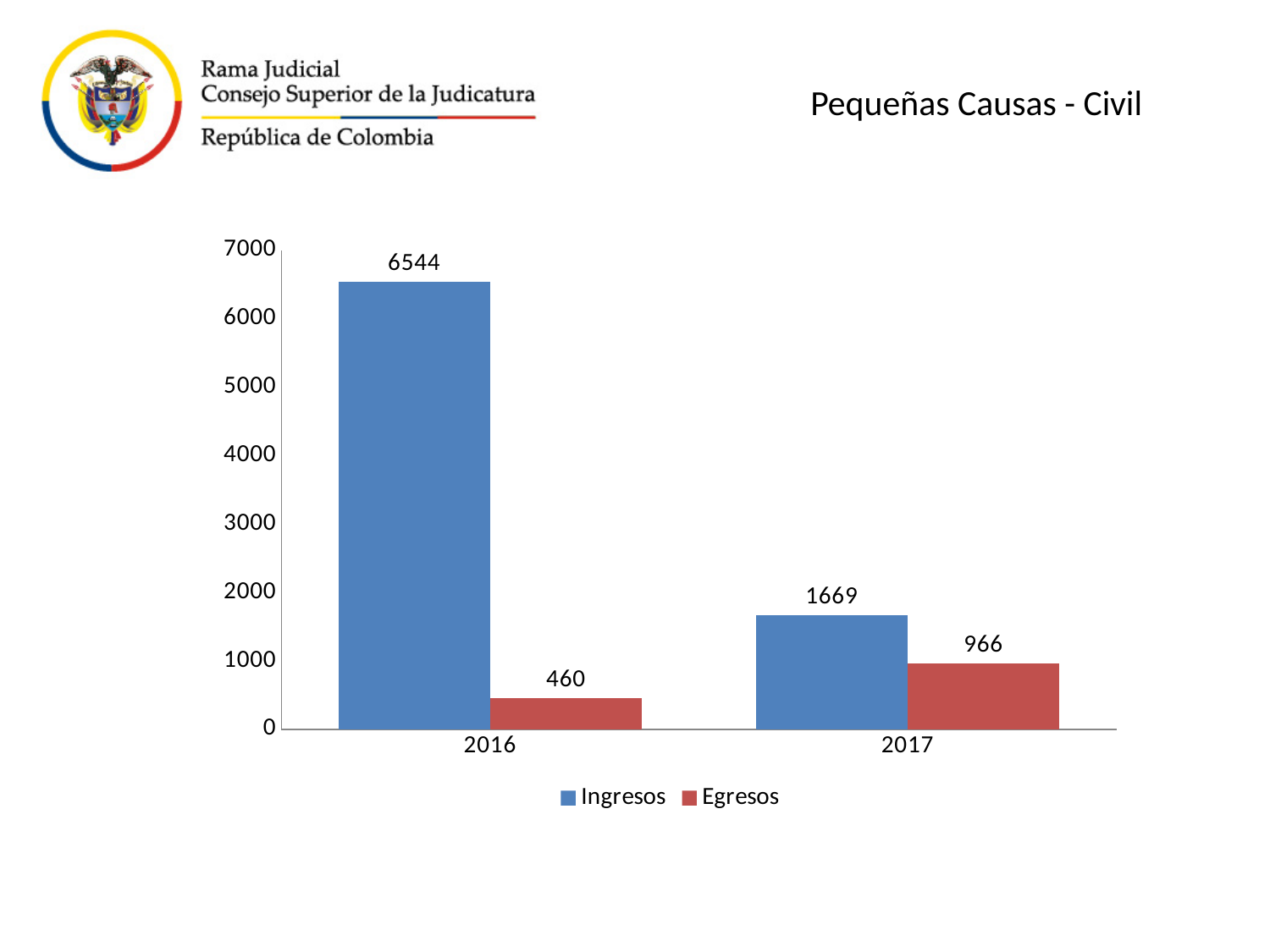
Which year has the lowest Egresos value? 2016 Which is larger in 2017, Ingresos or Egresos? Ingresos What is the value of Egresos for 2017? 966 What is the difference between Ingresos and Egresos in 2016? 6084 What kind of chart is shown on the slide? Bar chart What is the value of Ingresos for 2017? 1669 What is the difference between Ingresos and Egresos in 2017? 703 Do the Ingresos values rise or fall from 2016 to 2017? Fall How many series does the legend list? 2 Which year has the highest Ingresos value? 2016 What is the value of Ingresos for 2016? 6544 What is the value of Egresos for 2016? 460